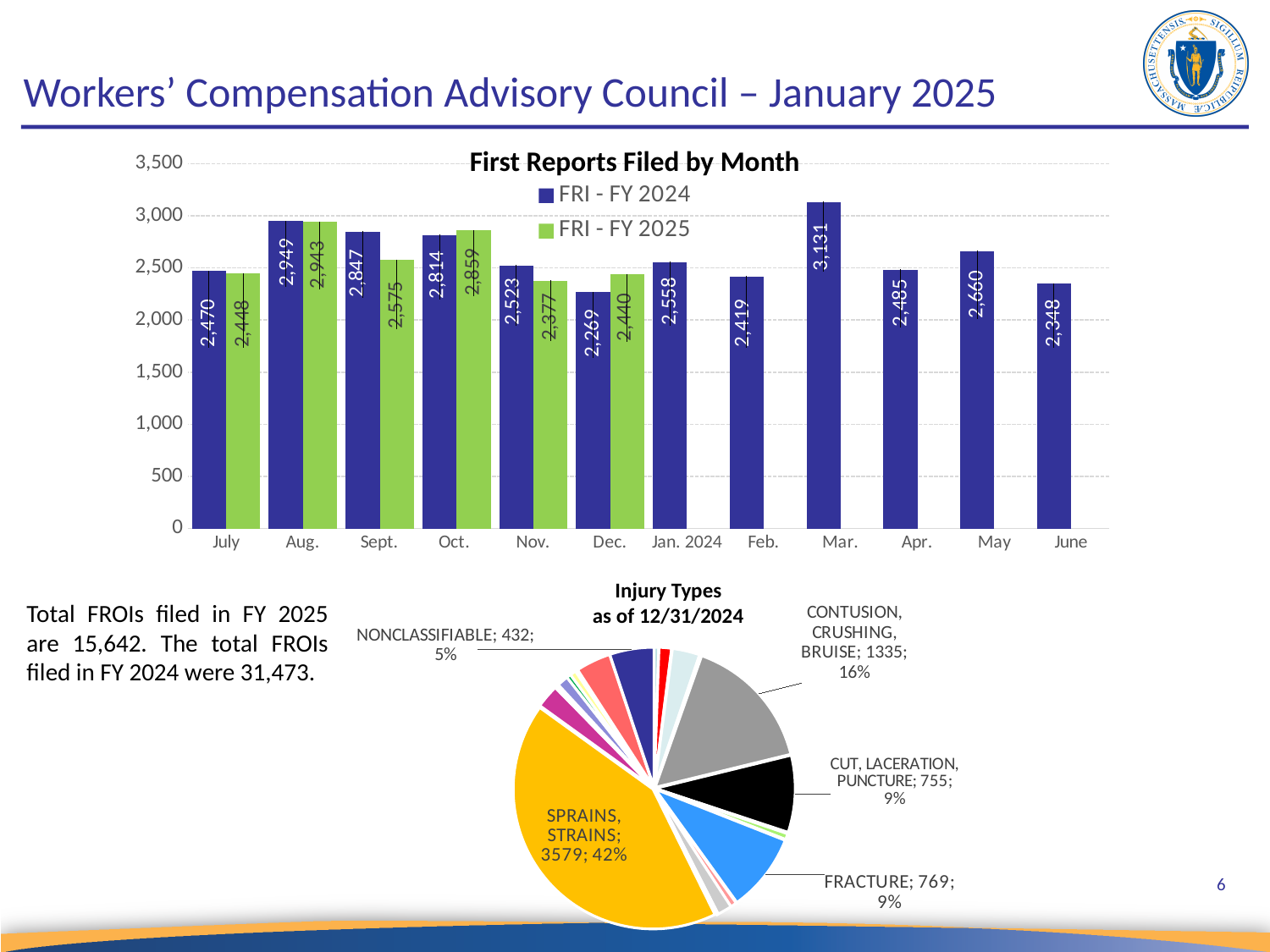
In the 'Injury Types as of 12/31/2024' pie chart, what share does CONTUSION, CRUSHING, BRUISE represent? 16% In the 'First Reports Filed by Month' chart, which month has the highest FRI - FY 2024 value? Mar. In the 'First Reports Filed by Month' chart, what is the FRI - FY 2025 value for Oct.? 2,859 What kind of chart is 'First Reports Filed by Month'? Bar chart In the 'First Reports Filed by Month' chart, what is the FRI - FY 2024 value for Mar.? 3,131 In the 'First Reports Filed by Month' chart, which series has the larger value for Dec., FRI - FY 2024 or FRI - FY 2025? FRI - FY 2025 How many series does the legend of the 'First Reports Filed by Month' chart list? 2 In the 'First Reports Filed by Month' chart, is the FRI - FY 2024 value for May greater or less than 2,500? greater In the 'First Reports Filed by Month' chart, how many months have an FRI - FY 2025 bar? 6 In the 'Injury Types as of 12/31/2024' pie chart, what is the count for SPRAINS, STRAINS? 3579 In the 'First Reports Filed by Month' chart, which month has the lowest FRI - FY 2024 value? Dec. In the 'First Reports Filed by Month' chart, what is the difference between the FY 2024 and FY 2025 values for Sept.? 272